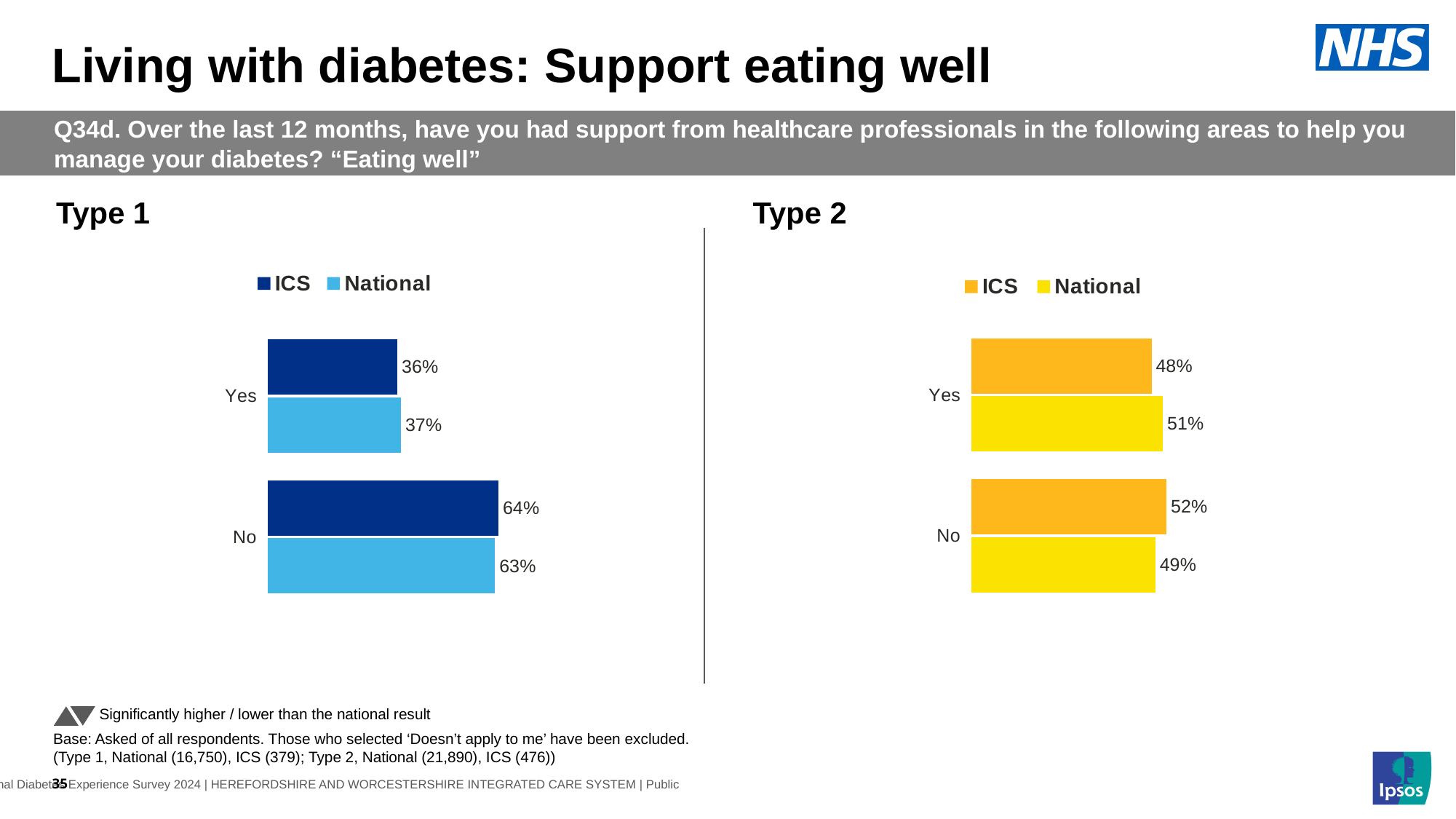
How many series does the legend of the Type 1 chart list? 2 In the Type 2 chart, what is the ICS value for Yes? 48% In the Type 1 chart, what is the National value for No? 63% In the Type 2 chart, what is the difference between the National and ICS values for Yes? 3 percentage points In the Type 2 chart, which category has the lowest National value? No In the Type 1 chart, which category has the highest ICS value? No What kind of chart is the Type 1 chart? Bar chart In the Type 2 chart, is the ICS value for Yes larger or smaller than the ICS value for No? smaller How many categories are shown in the Type 2 chart? 2 In the Type 1 chart, what is the difference between the ICS and National values for No? 1 percentage point In the Type 1 chart, what is the ICS value for Yes? 36% In the Type 2 chart, what is the National value for No? 49%